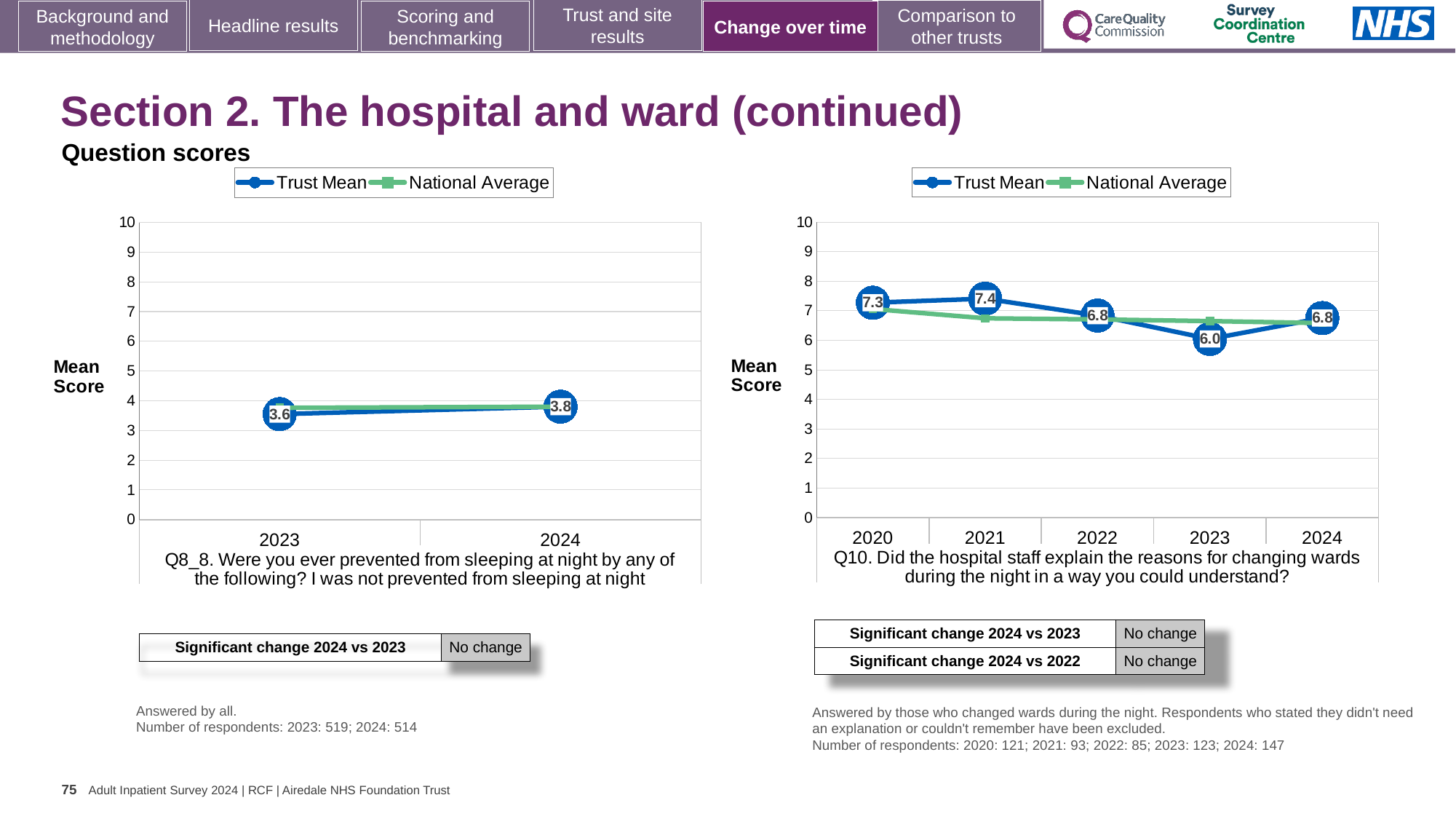
In the left chart (Q8_8), what is the Trust Mean score for 2023? 3.6 In the left chart (Q8_8), by how much did the Trust Mean change from 2023 to 2024? 0.2 In the right chart (Q10), which year has the lowest Trust Mean score? 2023 In the right chart (Q10), what is the Trust Mean score for 2021? 7.4 How many series does the legend of the left chart (Q8_8) list? 2 In the right chart (Q10), what is the difference between the Trust Mean in 2021 and in 2023? 1.4 How many years are plotted in the right chart (Q10)? 5 In the right chart (Q10), what is the Trust Mean score for 2023? 6.0 In the left chart (Q8_8), does the Trust Mean rise or fall from 2023 to 2024? rise In the right chart (Q10), which year has the highest Trust Mean score? 2021 In the right chart (Q10), is the Trust Mean higher in 2020 or in 2024? 2020 In the left chart (Q8_8), what is the Trust Mean score for 2024? 3.8